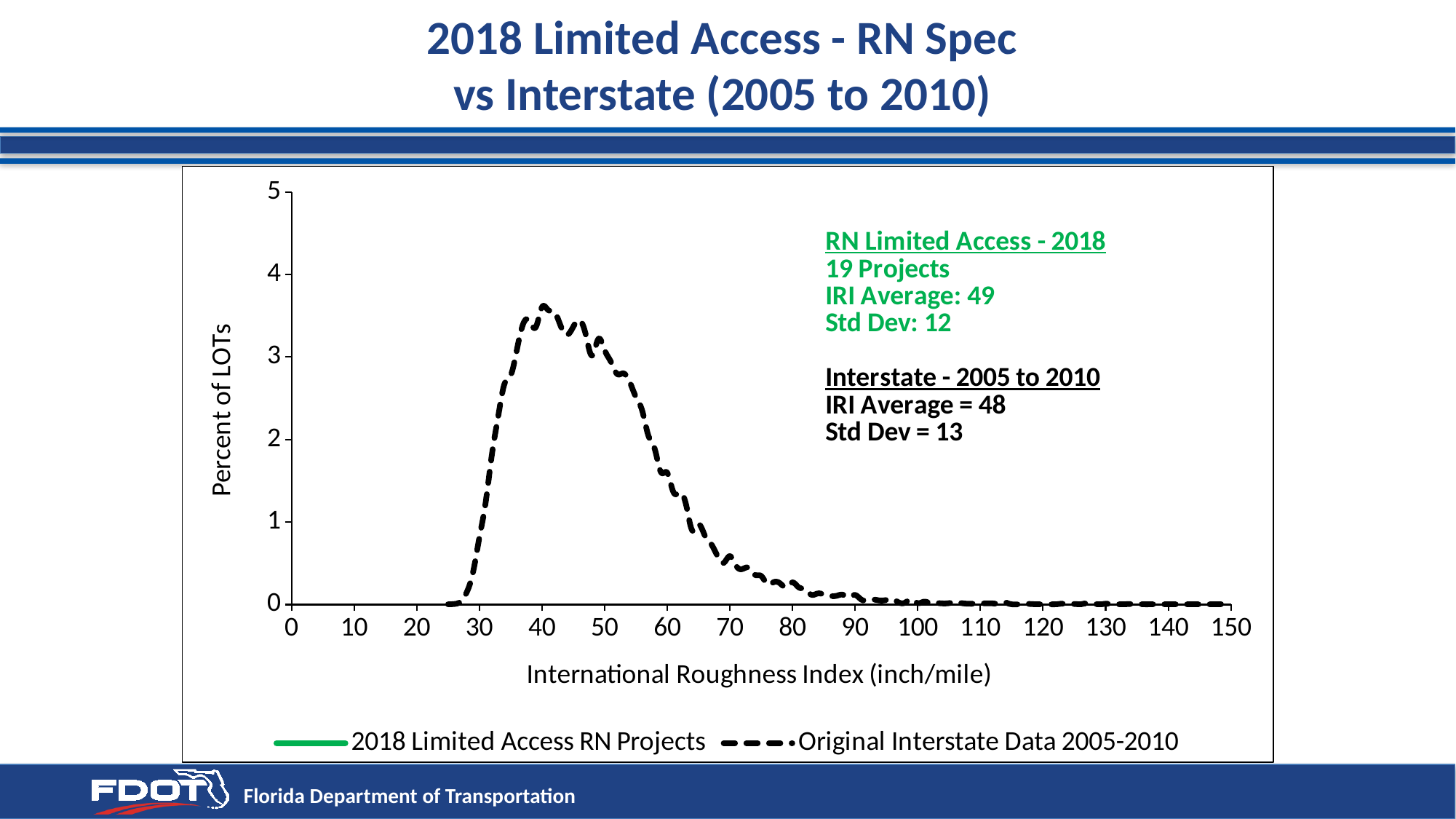
What is the label of the x axis? International Roughness Index (inch/mile) Is the value of the Original Interstate Data 2005-2010 line at an IRI of 80 greater or less than 1? less Is the value of the Original Interstate Data 2005-2010 line at an IRI of 30 greater or less than 2? less Is the value of the Original Interstate Data 2005-2010 line at an IRI of 40 greater or less than 3? greater According to the annotation on the chart, how many projects are in RN Limited Access - 2018? 19 Projects What is the label of the y axis? Percent of LOTs Does the Original Interstate Data 2005-2010 line rise or fall as the IRI increases from 25 to 40? rise Does the Original Interstate Data 2005-2010 line rise or fall as the IRI increases from 60 to 90? fall What kind of chart is shown on the slide? Line chart According to the annotation on the chart, what is the IRI Average for RN Limited Access - 2018? 49 How many series does the chart legend list? 2 According to the annotation on the chart, what is the Std Dev for Interstate - 2005 to 2010? 13